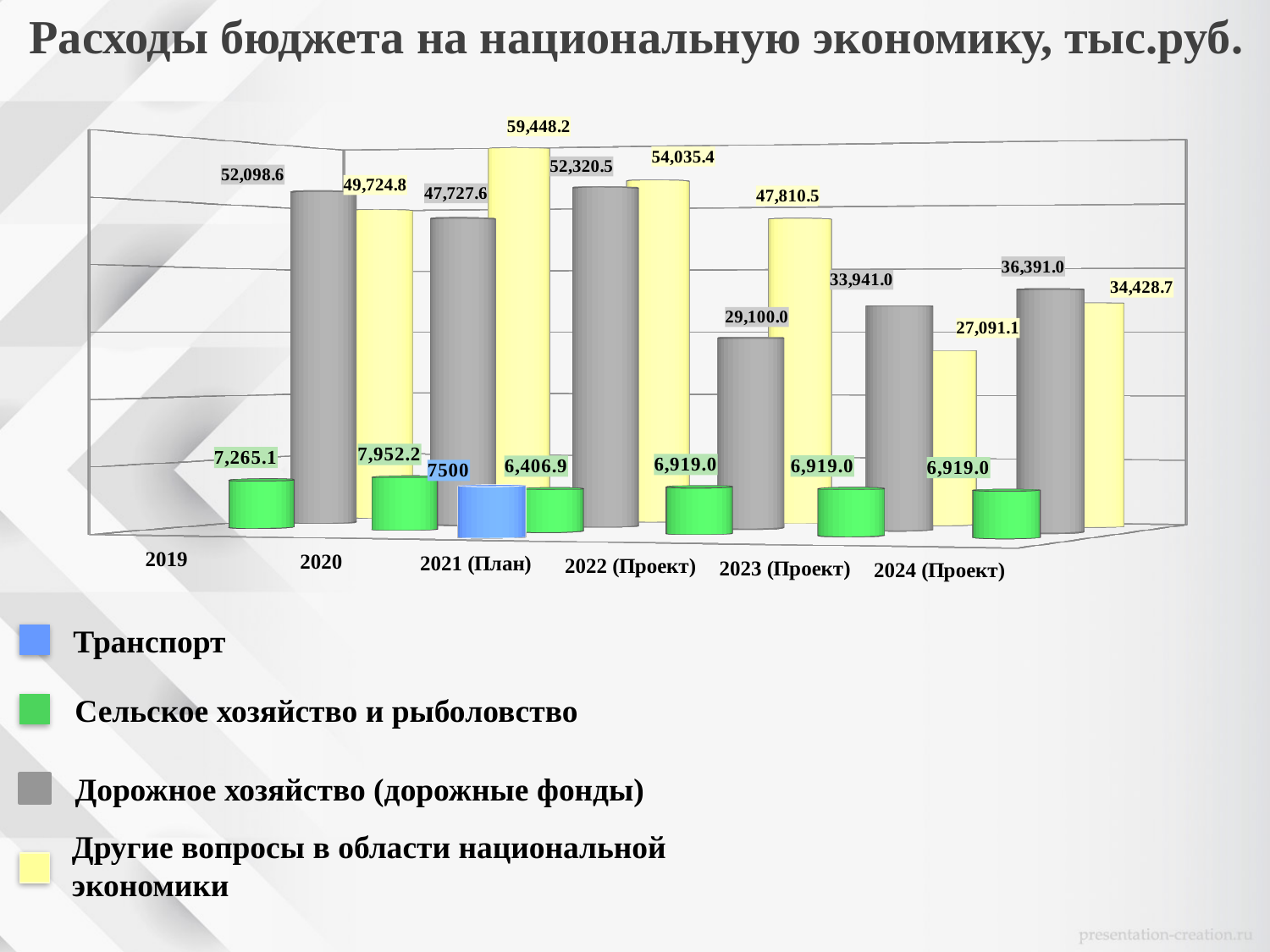
What is the difference between Дорожное хозяйство (дорожные фонды) and Другие вопросы в области национальной экономики in 2022 (Проект)? 18,710.5 In which year is the value for Дорожное хозяйство (дорожные фонды) the lowest? 2022 (Проект) What kind of chart is shown on the slide? Bar chart Which is larger in 2023 (Проект): Дорожное хозяйство (дорожные фонды) or Другие вопросы в области национальной экономики? Дорожное хозяйство (дорожные фонды) What is the value for Транспорт in 2021 (План)? 7500 In which year is the value for Другие вопросы в области национальной экономики the highest? 2020 What is the value for Сельское хозяйство и рыболовство in 2024 (Проект)? 6,919.0 How many series does the legend list? 4 What is the value for Дорожное хозяйство (дорожные фонды) in 2019? 52,098.6 How many years are shown on the x axis? 6 What is the value for Другие вопросы в области национальной экономики in 2020? 59,448.2 Which colour represents Транспорт in the legend? Blue